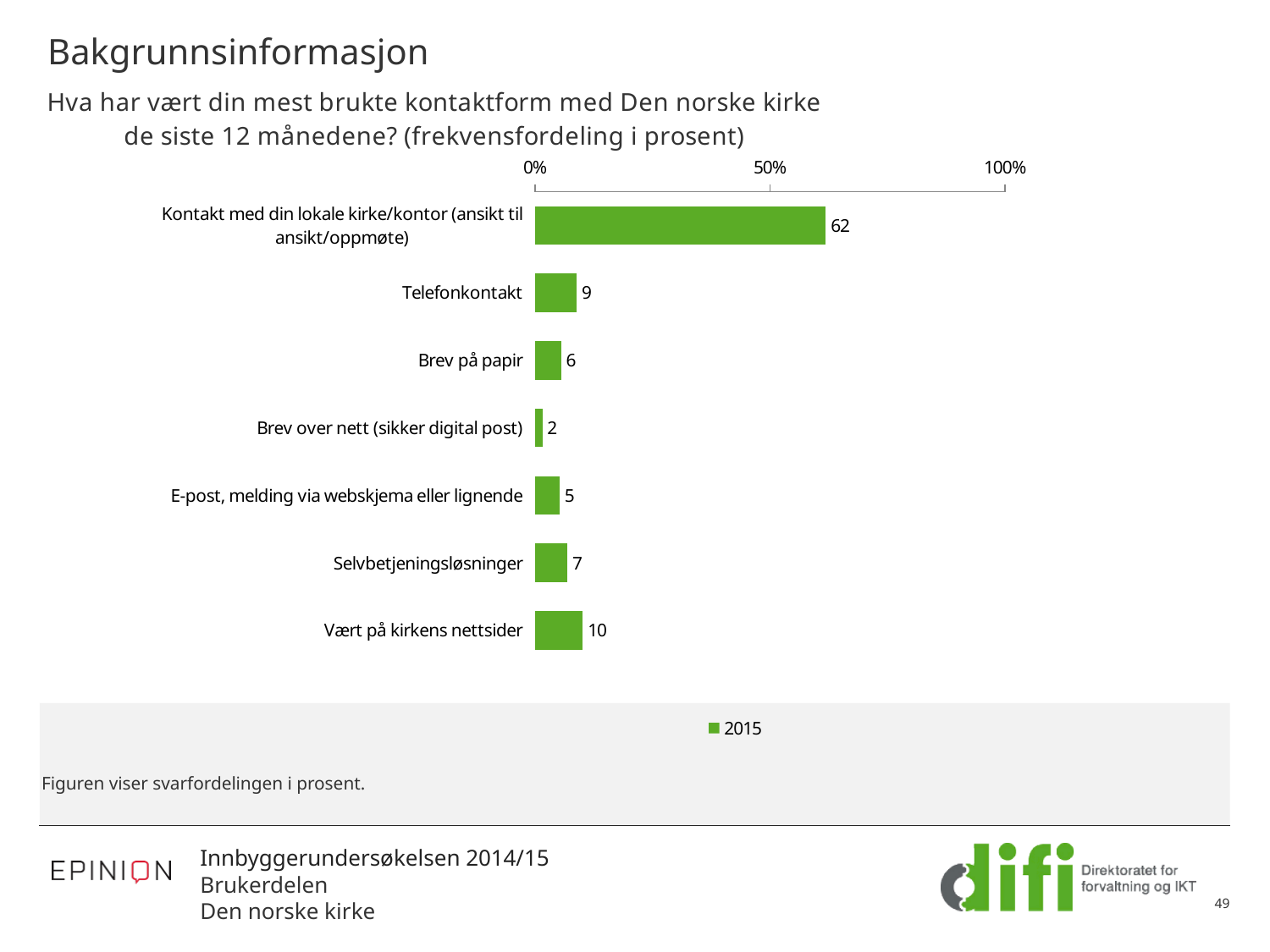
What is the difference between the values for Kontakt med din lokale kirke/kontor (ansikt til ansikt/oppmøte) and Vært på kirkens nettsider? 52 What kind of chart is shown on the slide? bar chart How many categories are shown in the chart? 7 Which category has the lowest value? Brev over nett (sikker digital post) What is the value for Telefonkontakt? 9 How many series does the legend list? 1 Which is larger, the value for Selvbetjeningsløsninger or the value for Brev på papir? Selvbetjeningsløsninger Which category has the highest value? Kontakt med din lokale kirke/kontor (ansikt til ansikt/oppmøte) What year does the legend entry show? 2015 Is the value for Kontakt med din lokale kirke/kontor (ansikt til ansikt/oppmøte) greater or less than 50%? greater What is the value for Vært på kirkens nettsider? 10 What is the value for Brev over nett (sikker digital post)? 2